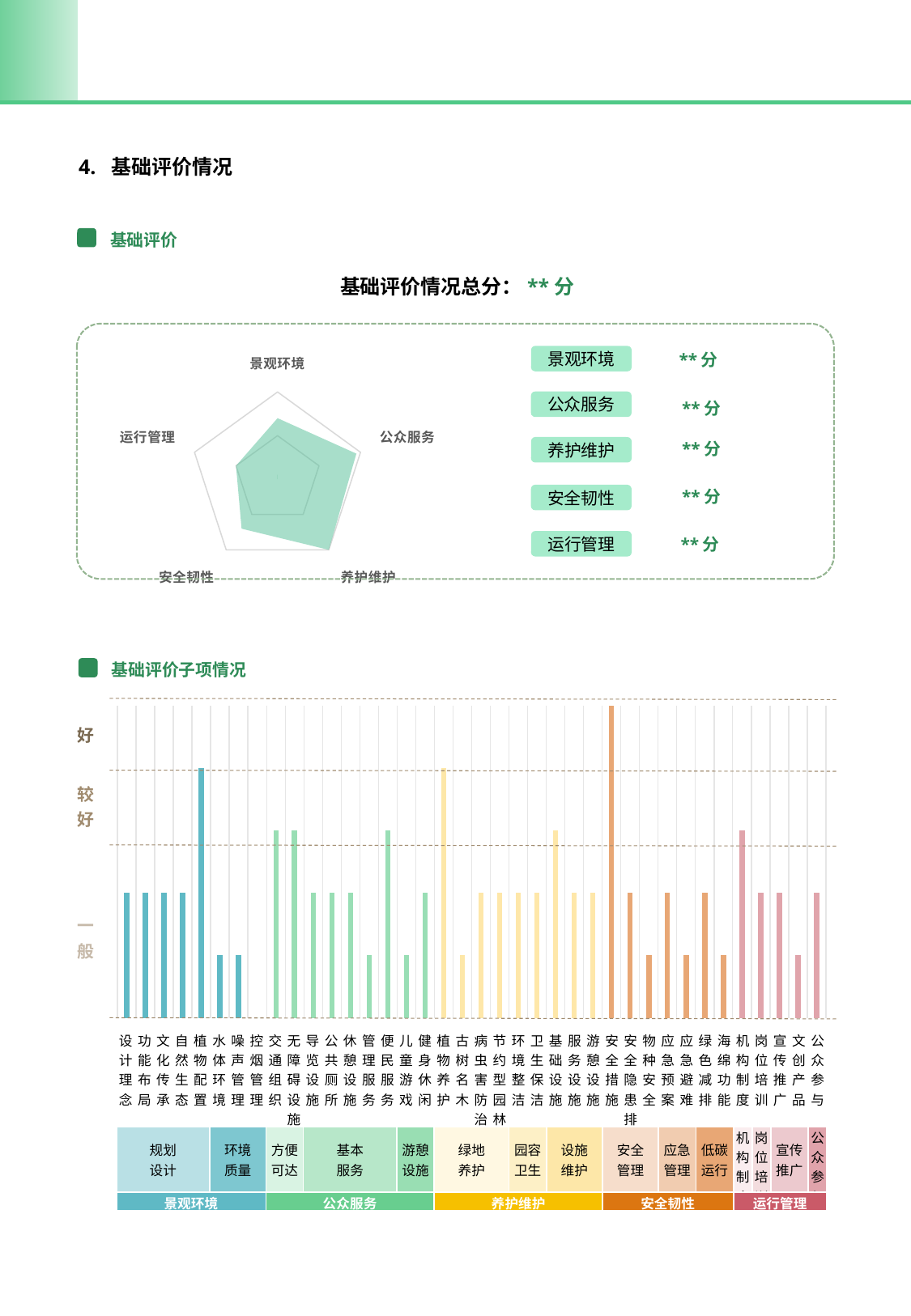
In the bar chart under 基础评价子项情况, which bar is taller: 机构制度 or 岗位培训? 机构制度 In the bar chart under 基础评价子项情况, which category has the tallest bar? 安全措施 What kind of chart is the chart under the heading 基础评价子项情况? Bar chart In the bar chart under 基础评价子项情况, what are the three rating levels labelled on the vertical axis, from top to bottom? 好, 较好, 一般 How many axes (dimensions) does the radar chart have? 5 In the bar chart under 基础评价子项情况, which top-level group do the orange bars belong to? 安全韧性 In the bar chart under 基础评价子项情况, which bar is taller: 植物配置 or 水体环境? 植物配置 In the bar chart under 基础评价子项情况, which bar is taller: 安全措施 or 植物养护? 安全措施 In the radar chart, which dimension is labelled at the top vertex? 景观环境 What kind of chart is the chart in the upper section of the slide, next to the score boxes? Radar chart In the bar chart under 基础评价子项情况, how many top-level groups (coloured bands at the bottom) are the categories divided into? 5